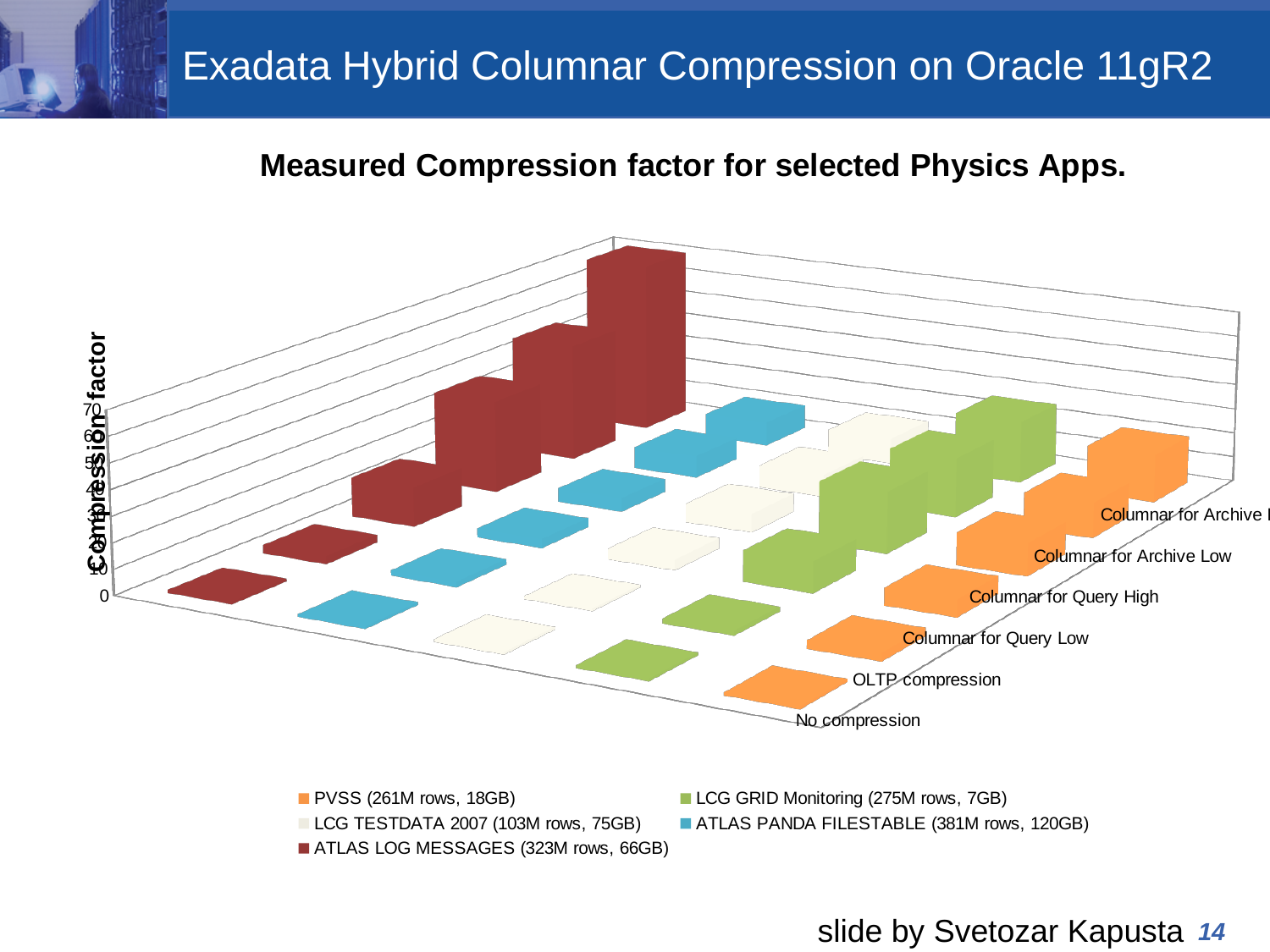
What is the title of the chart? Measured Compression factor for selected Physics Apps. How many compression categories are plotted along the category axis? 6 Which is larger for ATLAS LOG MESSAGES: the bar for No compression or the bar for Columnar for Archive High? Columnar for Archive High How many series does the legend list? 5 Which series is drawn in dark red? ATLAS LOG MESSAGES (323M rows, 66GB) For the ATLAS LOG MESSAGES series, do the compression factors rise or fall moving from No compression toward Columnar for Archive High? rise What kind of chart is shown on the slide? bar chart Which series reaches the highest compression factor on the chart? ATLAS LOG MESSAGES (323M rows, 66GB) Which series is drawn in orange? PVSS (261M rows, 18GB) Which is larger at the Columnar for Archive High category: the ATLAS LOG MESSAGES bar or the PVSS bar? ATLAS LOG MESSAGES